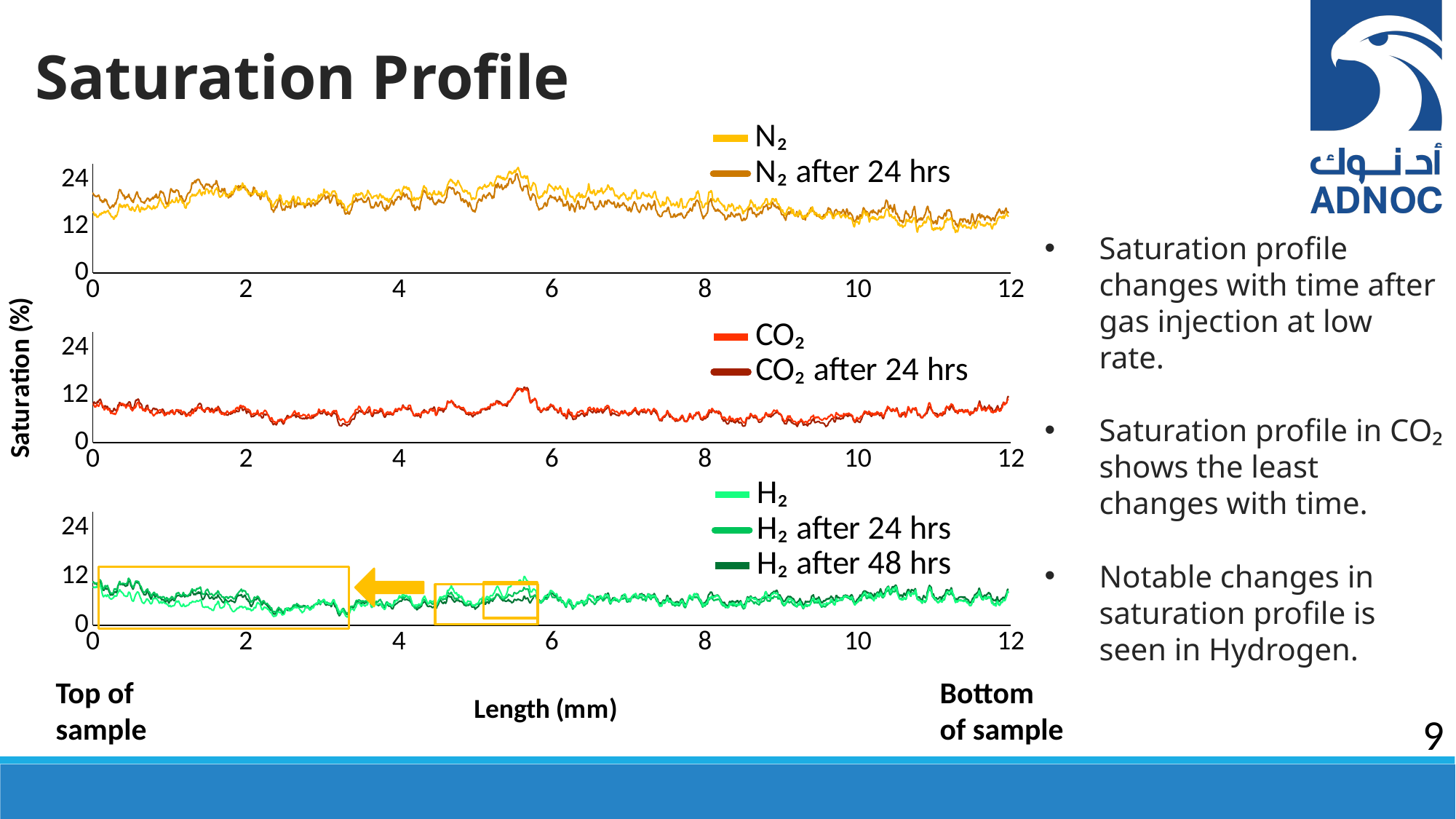
How many series does the legend of the middle (CO₂) chart list? 2 How many series does the legend of the bottom (H₂) chart list? 3 In the top (N₂) chart, does the N₂ saturation generally rise or fall from the top of the sample (0 mm) to the bottom (12 mm)? fall How many separate charts are shown on the slide? 3 In the bottom (H₂) chart, is the H₂ saturation at a length of 8 mm greater or less than 12? less At a length of 6 mm, which is higher: the N₂ saturation in the top chart or the CO₂ saturation in the middle chart? N₂ What is the label of the shared y axis of the charts? Saturation (%) How many series does the legend of the top (N₂) chart list? 2 In the middle (CO₂) chart, is the CO₂ saturation at a length of 2 mm greater or less than 12? less What kind of chart is the top chart showing N₂ saturation? line chart What is the label of the shared x axis of the charts? Length (mm) In the top (N₂) chart, is the N₂ saturation at a length of 2 mm greater or less than 12? greater